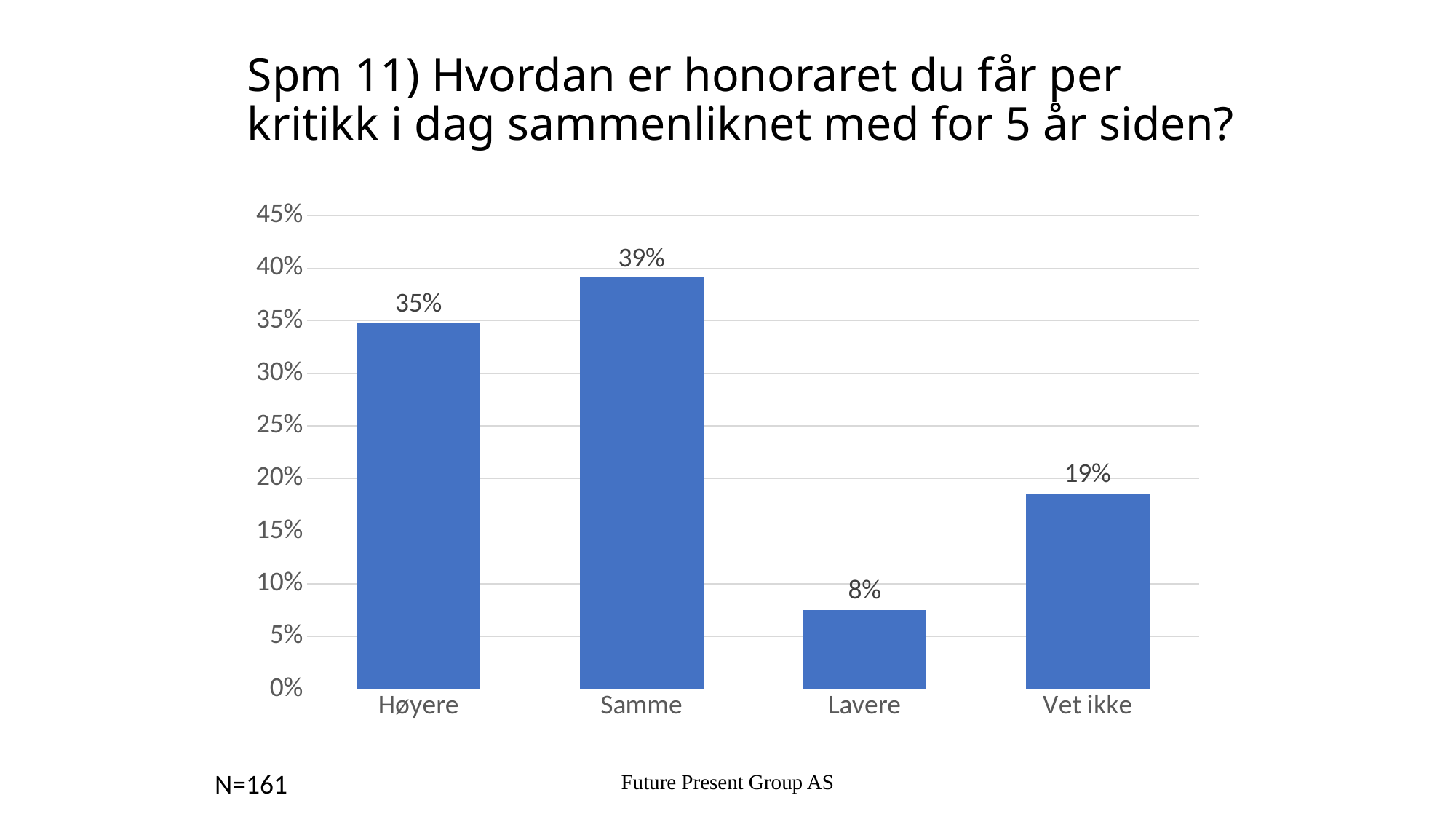
What is the value for Høyere? 35% Which category has the highest value? Samme What is the difference between the values for Vet ikke and Lavere? 11% What is the value for Lavere? 8% What is the difference between the values for Samme and Høyere? 4% What is the value for Vet ikke? 19% Is the value for Lavere greater or less than 10%? less What kind of chart is shown on the slide? bar chart Which is larger, the value for Høyere or the value for Vet ikke? Høyere What is the value for Samme? 39% Which category has the lowest value? Lavere How many categories are shown on the x axis? 4